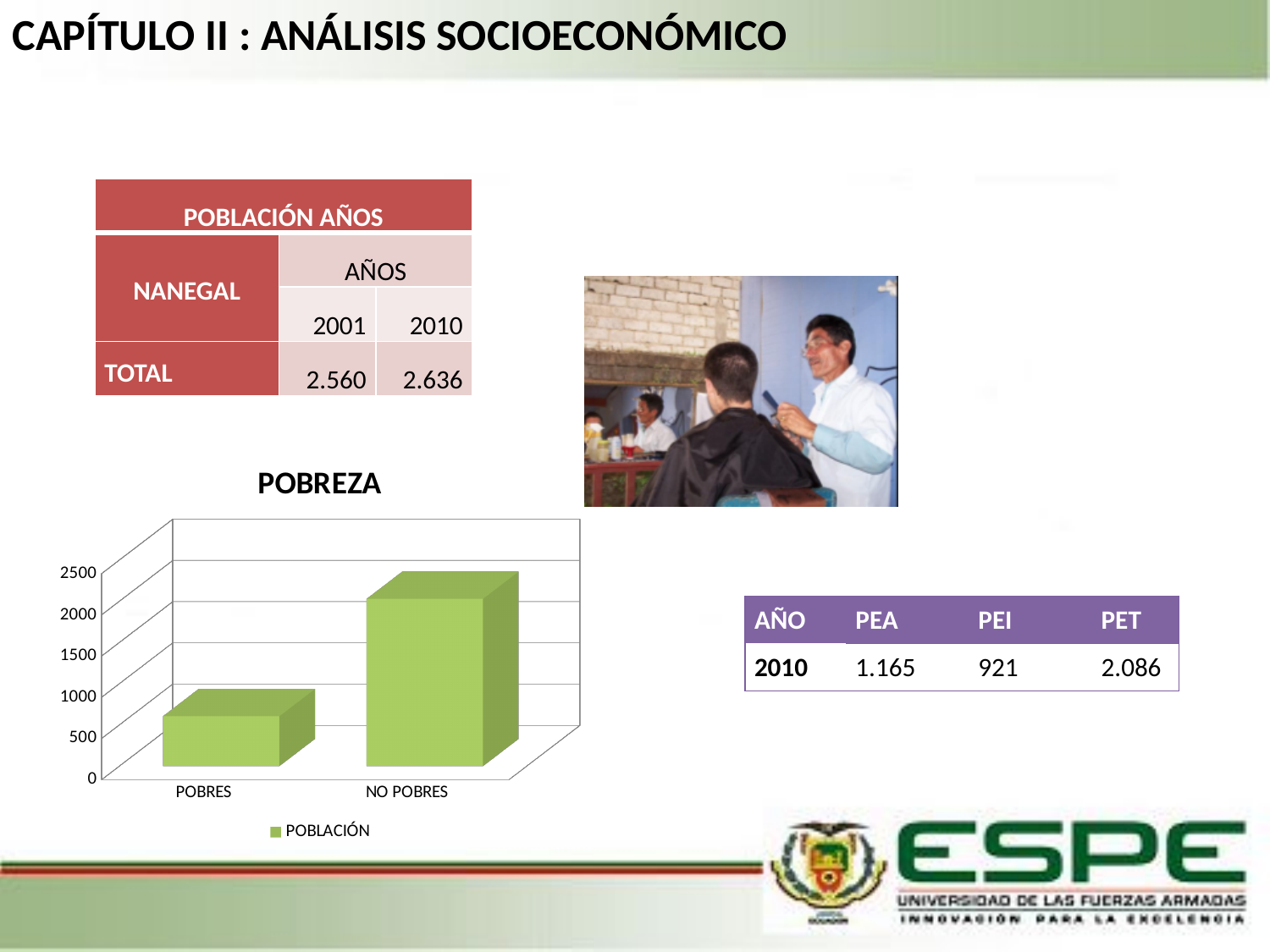
Which category has the lowest value in the POBREZA chart? POBRES In the POBREZA chart, is the value for NO POBRES greater or less than 2500? less What is the title of the bar chart on the slide? POBREZA How many categories are shown on the x axis of the POBREZA chart? 2 Which category has the highest value in the POBREZA chart? NO POBRES How many series does the legend of the POBREZA chart list? 1 What series name appears in the legend of the POBREZA chart? POBLACIÓN In the POBREZA chart, which is larger, the value for POBRES or the value for NO POBRES? NO POBRES What kind of chart is the POBREZA chart? bar chart In the POBREZA chart, is the value for NO POBRES greater or less than 1500? greater In the POBREZA chart, is the value for POBRES greater or less than 1000? less